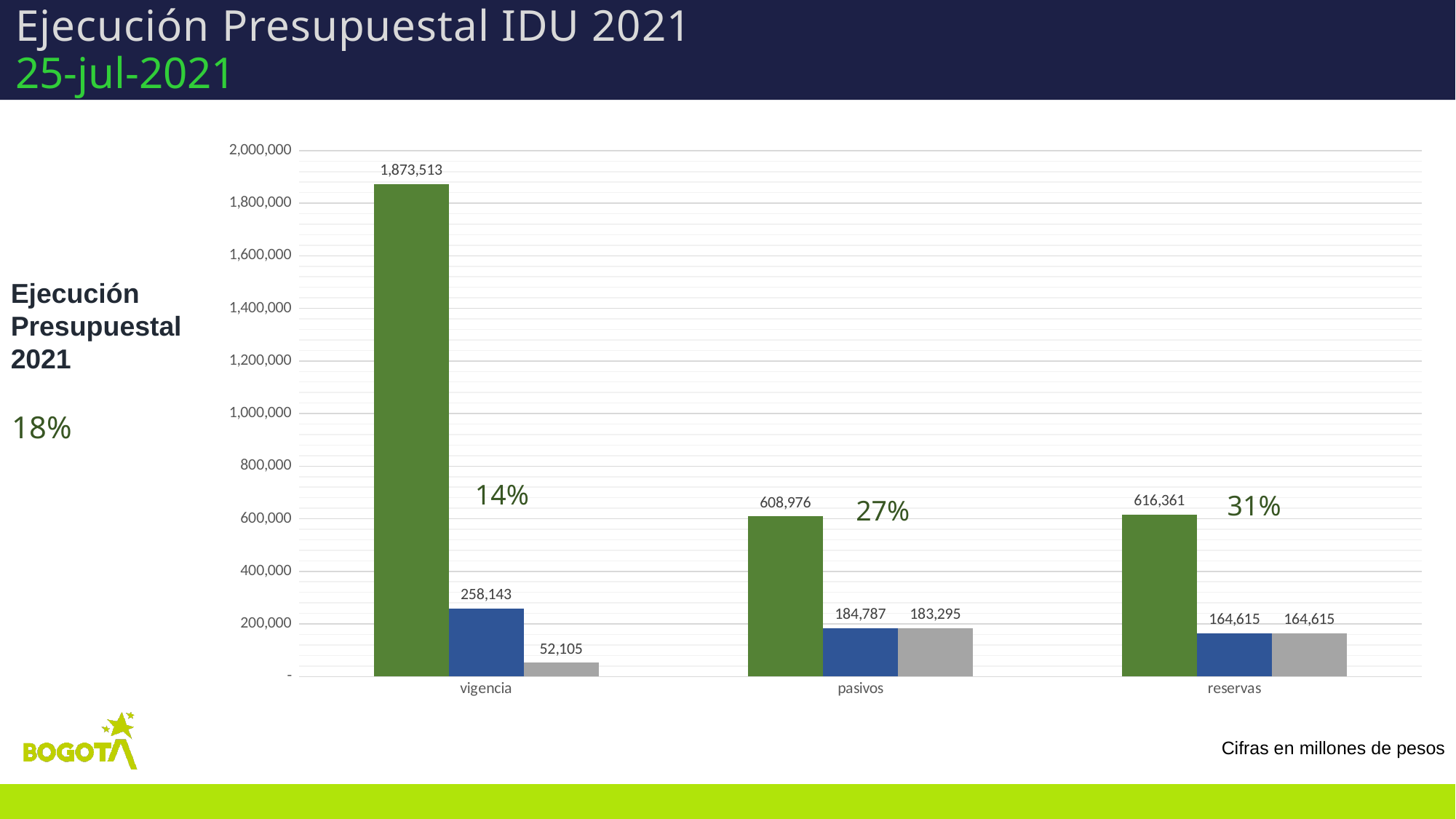
What is the value of the green bar for vigencia? 1,873,513 What type of chart is shown on the slide? bar chart What is the difference between the green bar and the blue bar for vigencia? 1,615,370 Is the value of the green bar for vigencia greater or less than 1,800,000? greater What is the value of the blue bar for pasivos? 184,787 Which is larger, the green bar for pasivos or the green bar for reservas? reservas Which category has the highest green bar? vigencia Which category has the lowest grey bar? vigencia What is the value of the grey bar for reservas? 164,615 What is the difference between the blue bar and the grey bar for pasivos? 1,492 How many categories are shown on the x axis? 3 What is the value of the grey bar for vigencia? 52,105